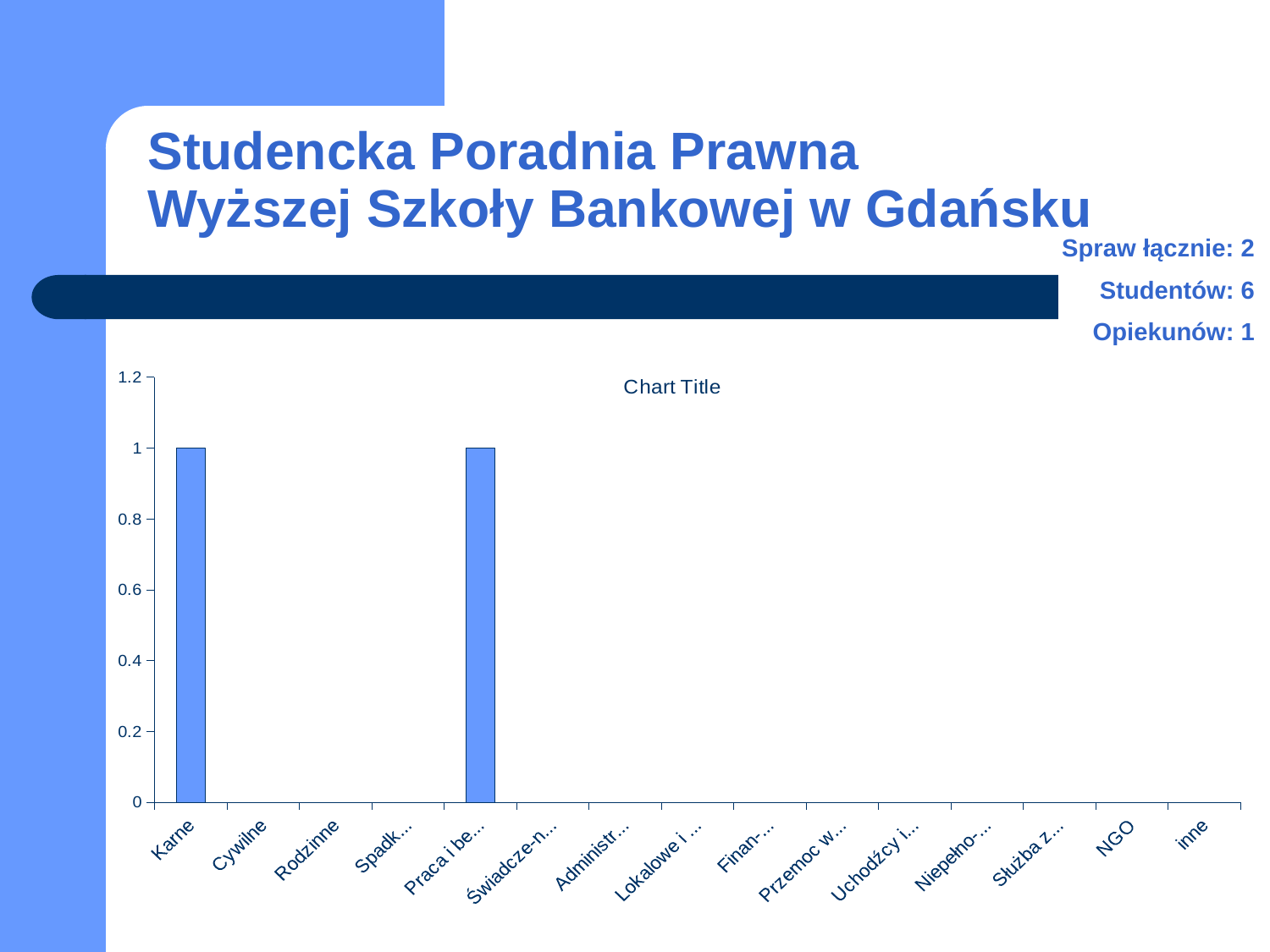
What is the value for Cywilne? 0 What kind of chart is shown on the slide? bar chart What is the value for the category labelled "Praca i be..."? 1 How many categories have a bar with a value above 0? 2 How many categories are shown on the x axis? 15 Is the value for Karne greater or less than 0.8? greater What is the title of the chart? Chart Title What is the value for Karne? 1 Which is larger, the value for Karne or the value for Cywilne? Karne What is the value for NGO? 0 What is the value for Rodzinne? 0 What is the difference between the value for Karne and the value for Cywilne? 1